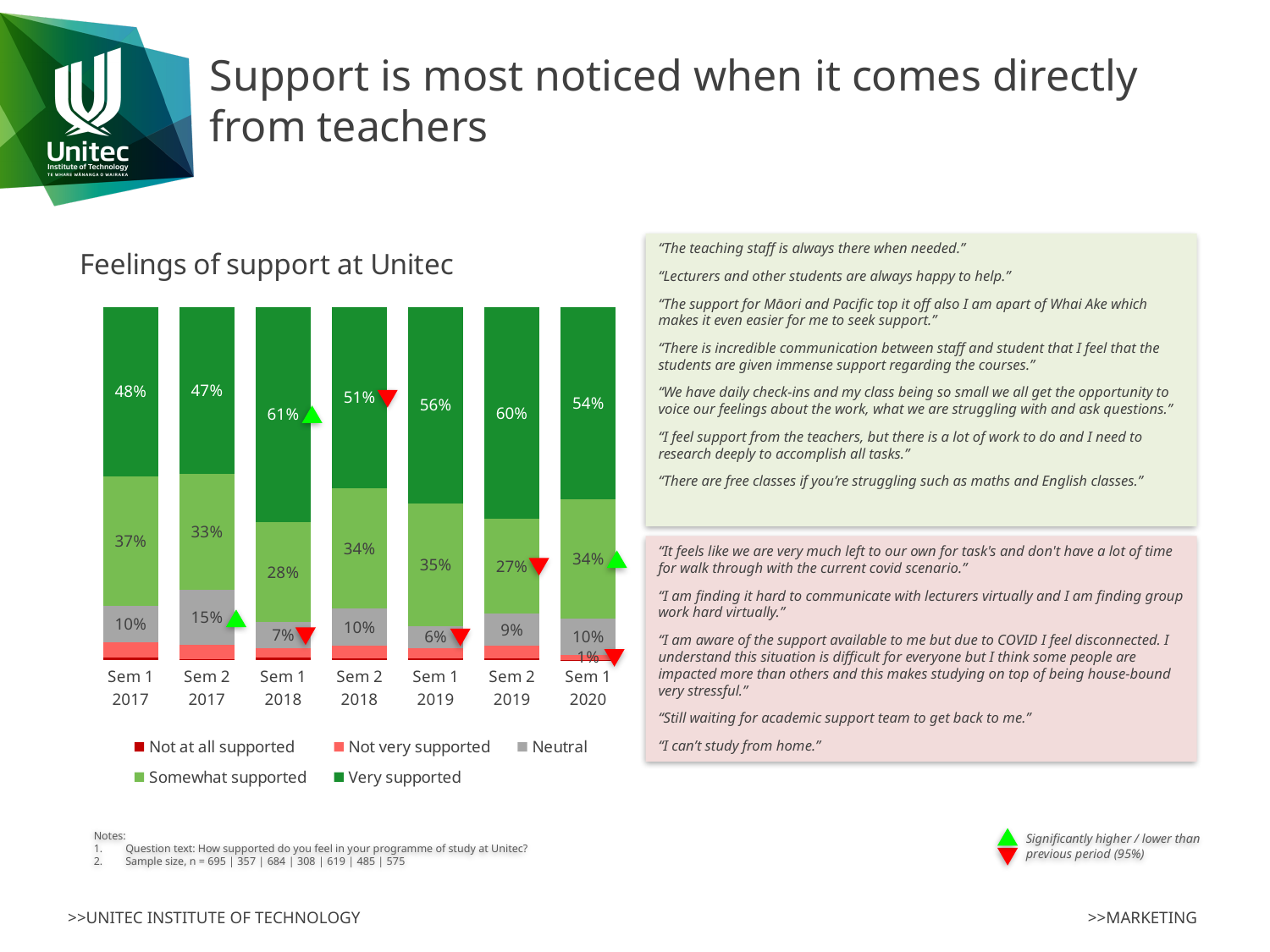
In which semester was the 'Neutral' share lowest? Sem 1 2019 What is the difference in percentage points between the 'Very supported' values for Sem 1 2018 and Sem 2 2017? 14 percentage points What is the 'Neutral' value for Sem 2 2017? 15% In which semester was the 'Very supported' share lowest? Sem 2 2017 What is the 'Somewhat supported' value for Sem 2 2019? 27% What percentage of respondents were 'Very supported' in Sem 1 2018? 61% What type of chart is 'Feelings of support at Unitec'? Stacked bar chart What is the 'Not very supported' value shown for Sem 1 2020? 1% Which is larger: the 'Somewhat supported' value in Sem 1 2017 or in Sem 1 2018? Sem 1 2017 How many series does the chart legend list? 5 How many semesters are shown on the x axis of the chart? 7 In which semester was the 'Very supported' share highest? Sem 1 2018